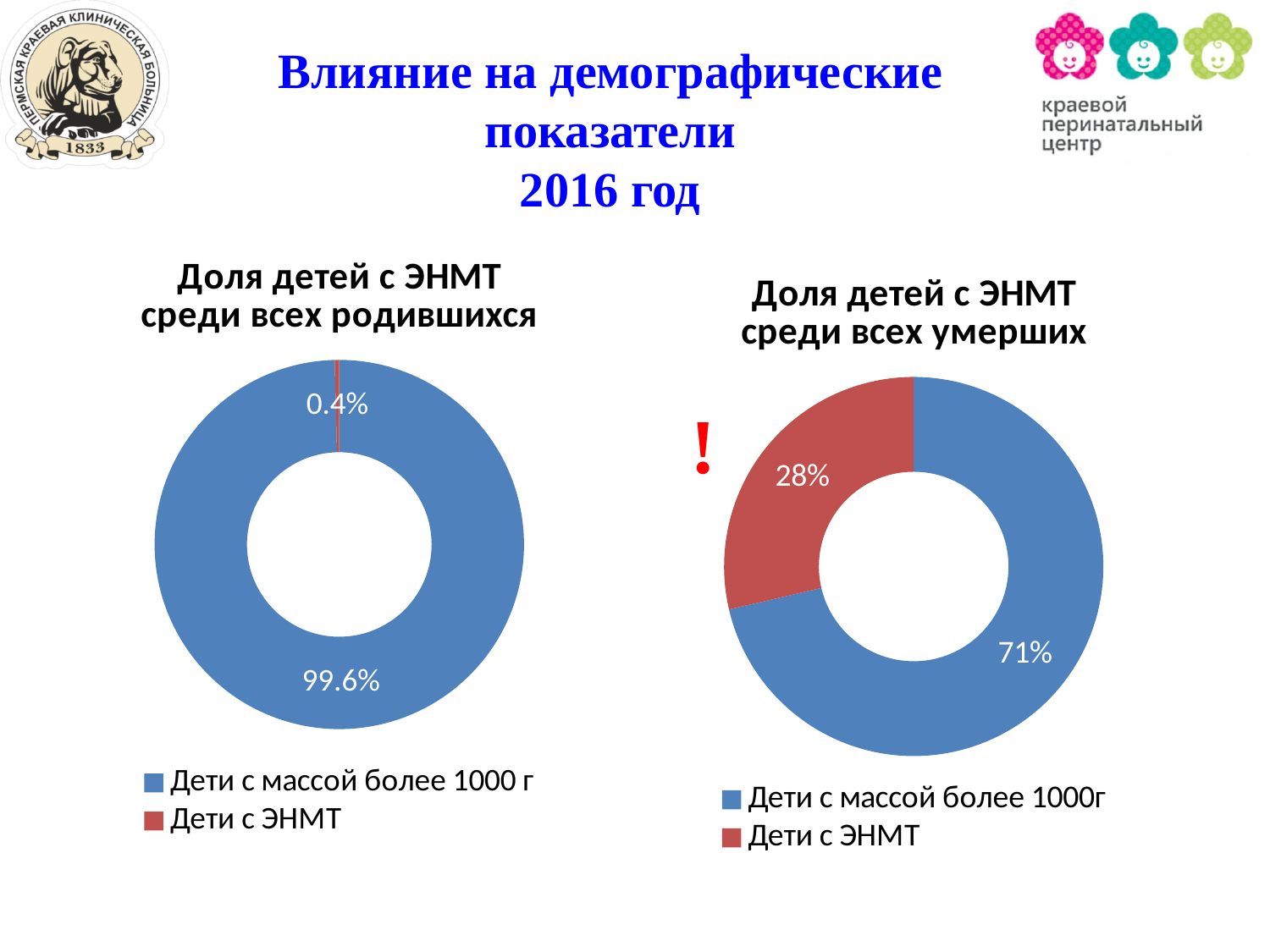
How many categories does the legend of the chart titled "Доля детей с ЭНМТ среди всех умерших" list? 2 In the chart titled "Доля детей с ЭНМТ среди всех родившихся", which category has the smallest share? Дети с ЭНМТ In the chart titled "Доля детей с ЭНМТ среди всех умерших", which category has the largest share? Дети с массой более 1000г What colour represents "Дети с ЭНМТ" in both charts? Red In the chart titled "Доля детей с ЭНМТ среди всех умерших", what is the difference in percentage points between the two slices? 43 How many charts are shown on the slide? 2 Which is larger: the share of "Дети с ЭНМТ" in the left chart (среди всех родившихся) or in the right chart (среди всех умерших)? The right chart (среди всех умерших) What type of chart is used on the left of the slide? Doughnut (pie) chart In the chart titled "Доля детей с ЭНМТ среди всех родившихся", what share is shown for "Дети с массой более 1000 г"? 99.6% In the chart titled "Доля детей с ЭНМТ среди всех умерших", what share is shown for "Дети с ЭНМТ"? 28% In the chart titled "Доля детей с ЭНМТ среди всех родившихся", what share is shown for "Дети с ЭНМТ"? 0.4% In the chart titled "Доля детей с ЭНМТ среди всех умерших", what share is shown for "Дети с массой более 1000г"? 71%